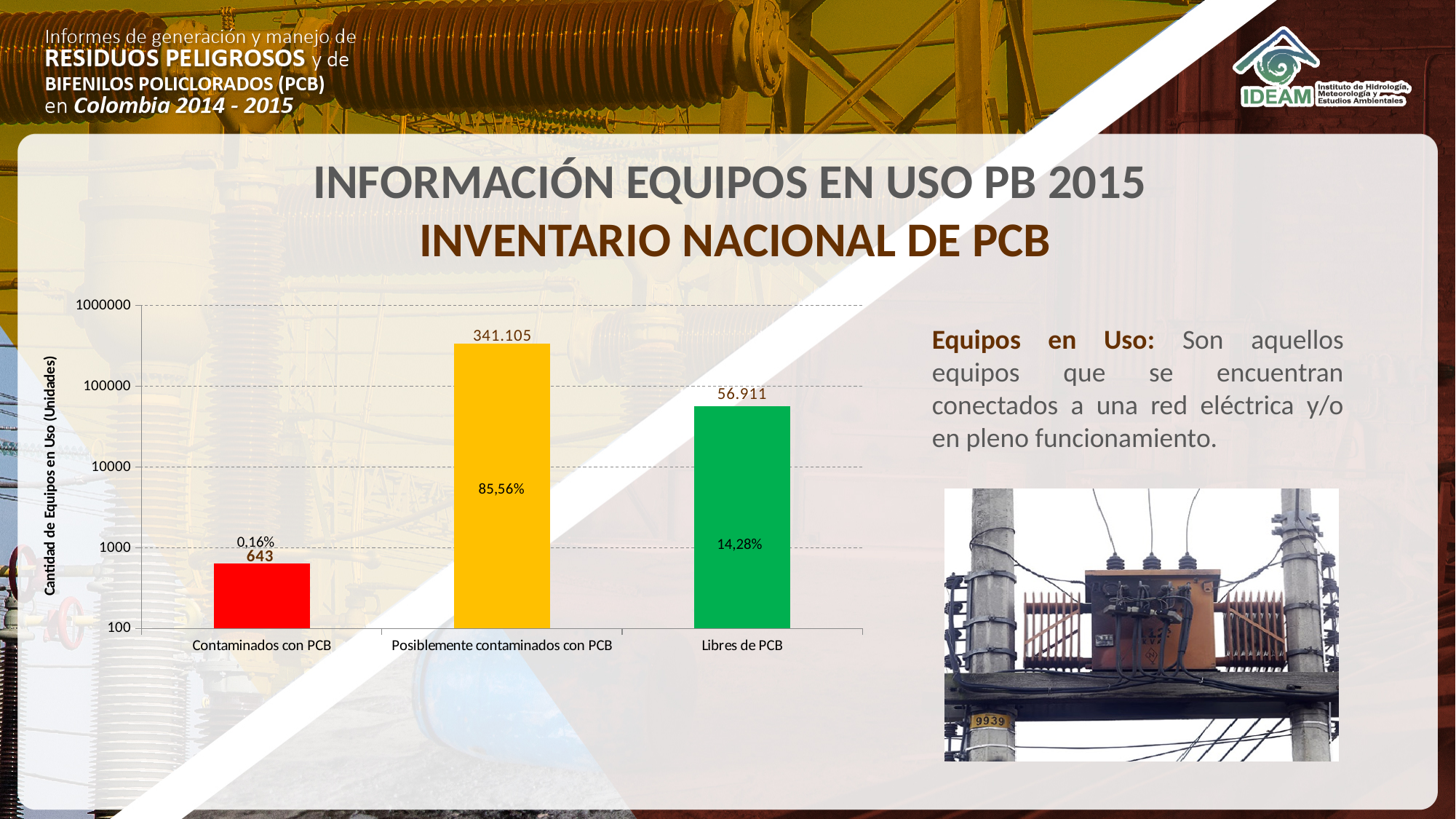
What is the difference between the values for Posiblemente contaminados con PCB and Libres de PCB? 284.194 What percentage is shown on the bar for Libres de PCB? 14,28% What is the value for Libres de PCB? 56.911 How many categories are shown on the x axis of the chart? 3 What percentage is shown for Contaminados con PCB? 0,16% Which category has the highest value? Posiblemente contaminados con PCB What is the value for Contaminados con PCB? 643 Which is larger, the value for Libres de PCB or the value for Contaminados con PCB? Libres de PCB Is the value for Contaminados con PCB greater or less than 1000? less Which category has the lowest value? Contaminados con PCB What kind of chart is shown on the slide? bar chart What is the value for Posiblemente contaminados con PCB? 341.105